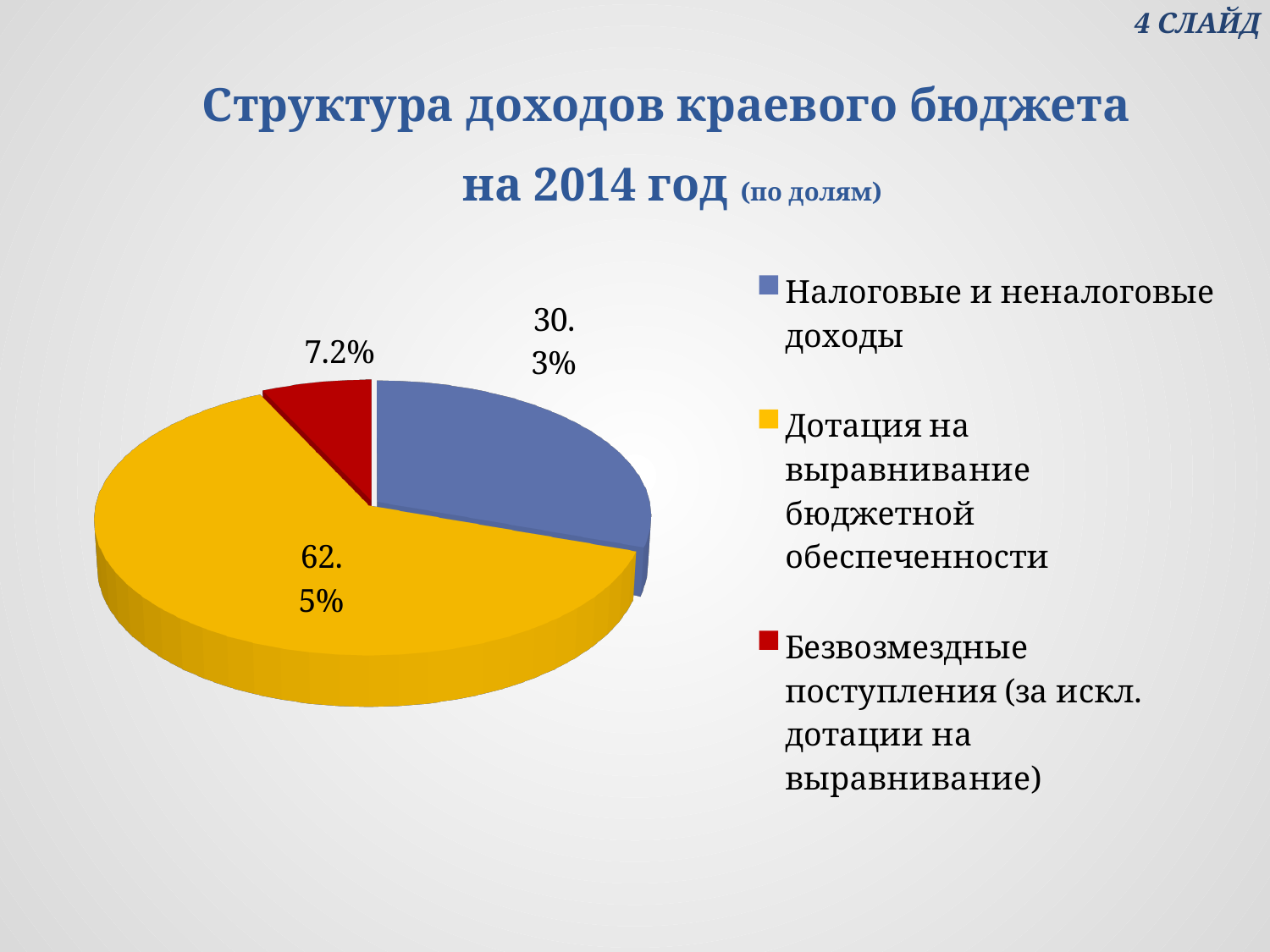
What is the title of the chart on the slide? Структура доходов краевого бюджета на 2014 год (по долям) What share of the pie is labelled for "Дотация на выравнивание бюджетной обеспеченности"? 62.5% Which category has the smallest slice of the pie? Безвозмездные поступления (за искл. дотации на выравнивание) What kind of chart is shown on the slide? Pie chart What share of the pie is labelled for "Безвозмездные поступления (за искл. дотации на выравнивание)"? 7.2% What is the difference between the shares of "Дотация на выравнивание бюджетной обеспеченности" and "Налоговые и неналоговые доходы"? 32.2% Which is larger: the share of "Налоговые и неналоговые доходы" or the share of "Безвозмездные поступления (за искл. дотации на выравнивание)"? Налоговые и неналоговые доходы Which category has the largest slice of the pie? Дотация на выравнивание бюджетной обеспеченности How many entries does the legend list? 3 What share of the pie is labelled for "Налоговые и неналоговые доходы"? 30.3% How many slices does the pie chart have? 3 What colour is the slice for "Дотация на выравнивание бюджетной обеспеченности"? Yellow